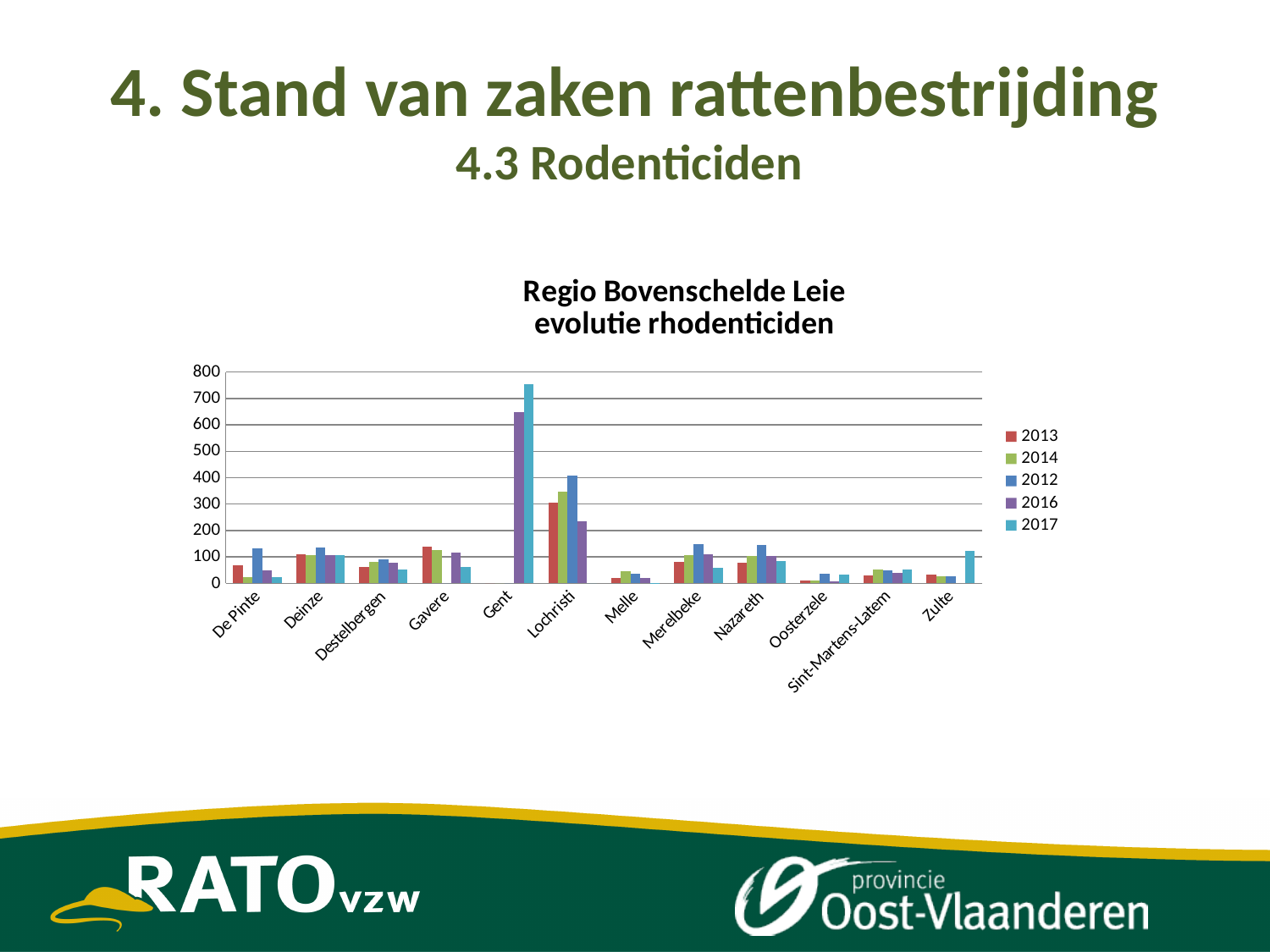
What kind of chart is shown on the slide? bar chart What is the title of the chart? Regio Bovenschelde Leie evolutie rhodenticiden Which year has the highest value for Zulte? 2017 Is the 2017 value for Gent greater or less than 700? greater Which year has the highest value for Gent? 2017 Which is larger for Lochristi, the 2012 value or the 2013 value? 2012 Is the 2016 value for Lochristi greater or less than 300? less How many municipalities (categories) are shown on the x axis of the chart? 12 Which municipality has the highest bar in the chart? Gent How many series does the legend of the chart list? 5 Is the 2016 value for Gent greater or less than 600? greater